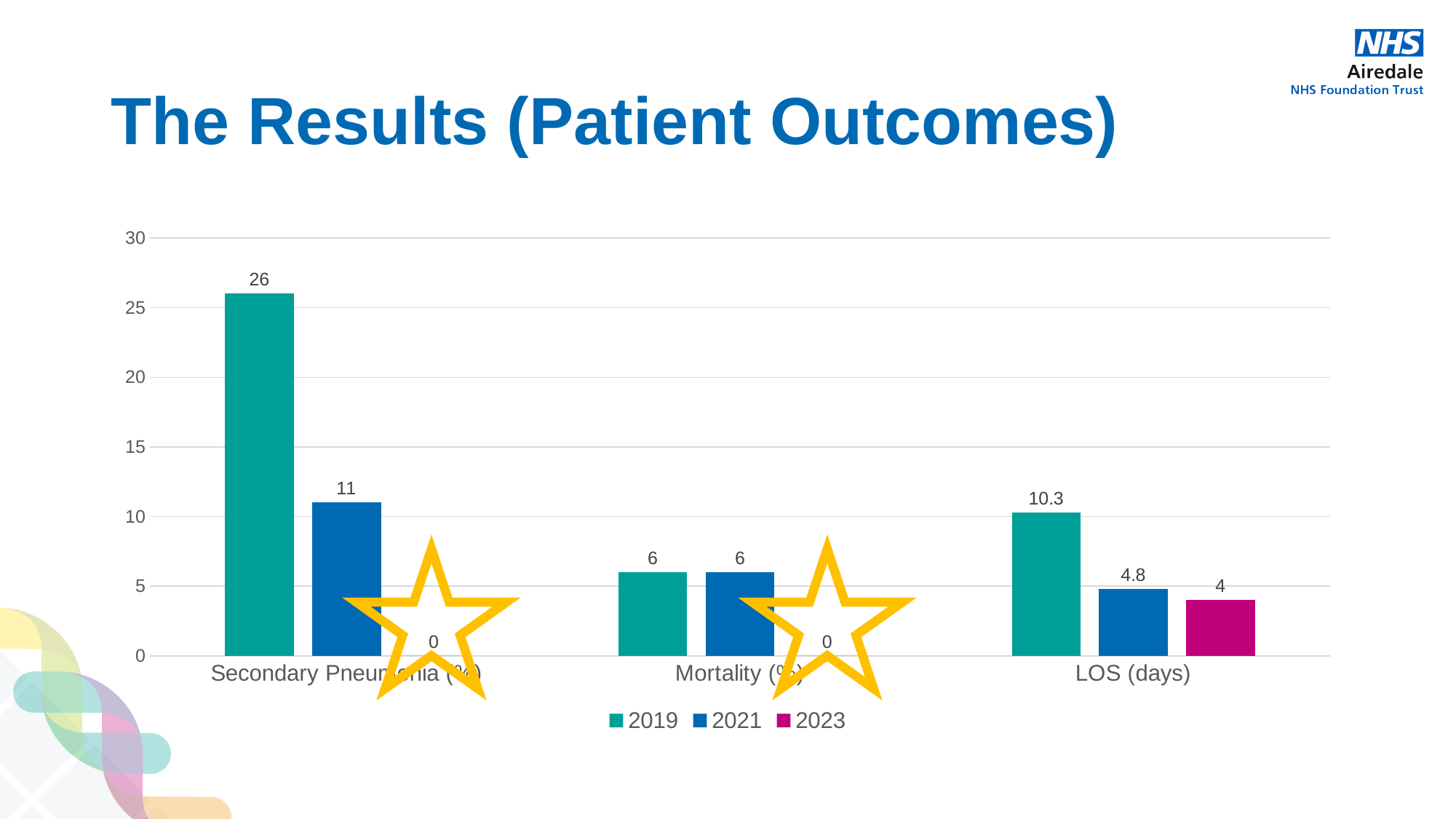
What is the value for 2021 in the Secondary Pneumonia (%) category? 11 Which year has the lowest value in the LOS (days) category? 2023 How many categories are shown on the x axis? 3 What kind of chart is shown on the slide? Bar chart How many series does the legend list? 3 What is the value for 2019 in the LOS (days) category? 10.3 What is the difference between the 2019 and 2021 values for Secondary Pneumonia (%)? 15 What is the value for 2019 in the Secondary Pneumonia (%) category? 26 Which is larger, the 2021 value for LOS (days) or the 2023 value for LOS (days)? 2021 What is the value for 2021 in the LOS (days) category? 4.8 Which year has the highest value in the Secondary Pneumonia (%) category? 2019 What is the value for 2023 in the Mortality (%) category? 0